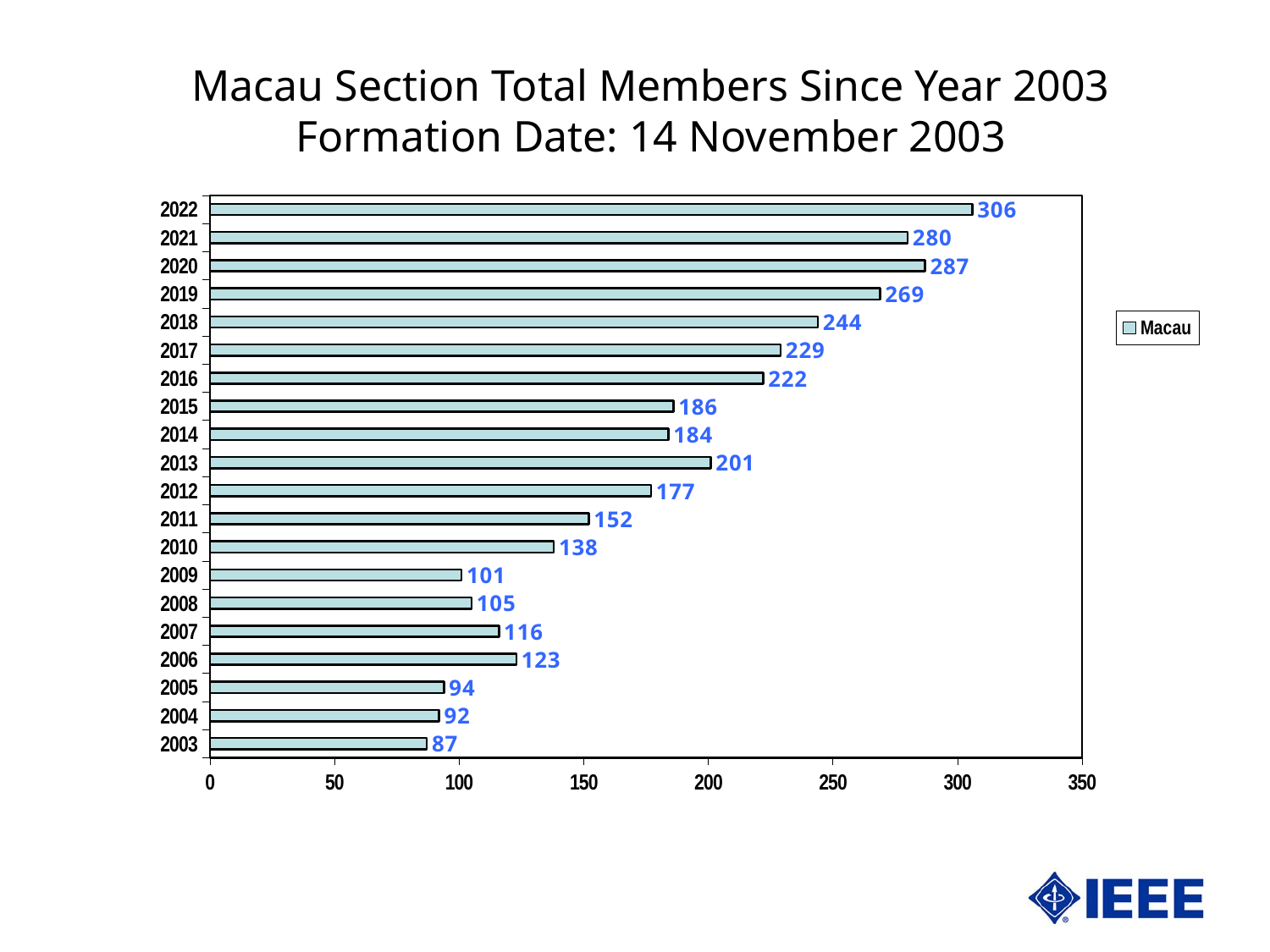
What is the total number of members for 2022? 306 What is the total number of members for 2003? 87 What is the only entry listed in the chart's legend? Macau What is the total number of members for 2013? 201 How many years are shown in the chart? 20 Which year has more members, 2008 or 2009? 2008 What kind of chart is shown on the slide? Bar chart Which year has more members, 2020 or 2021? 2020 What is the difference in members between 2022 and 2021? 26 What is the difference in members between 2020 and 2003? 200 Which year has the lowest number of members? 2003 Which year has the highest number of members? 2022